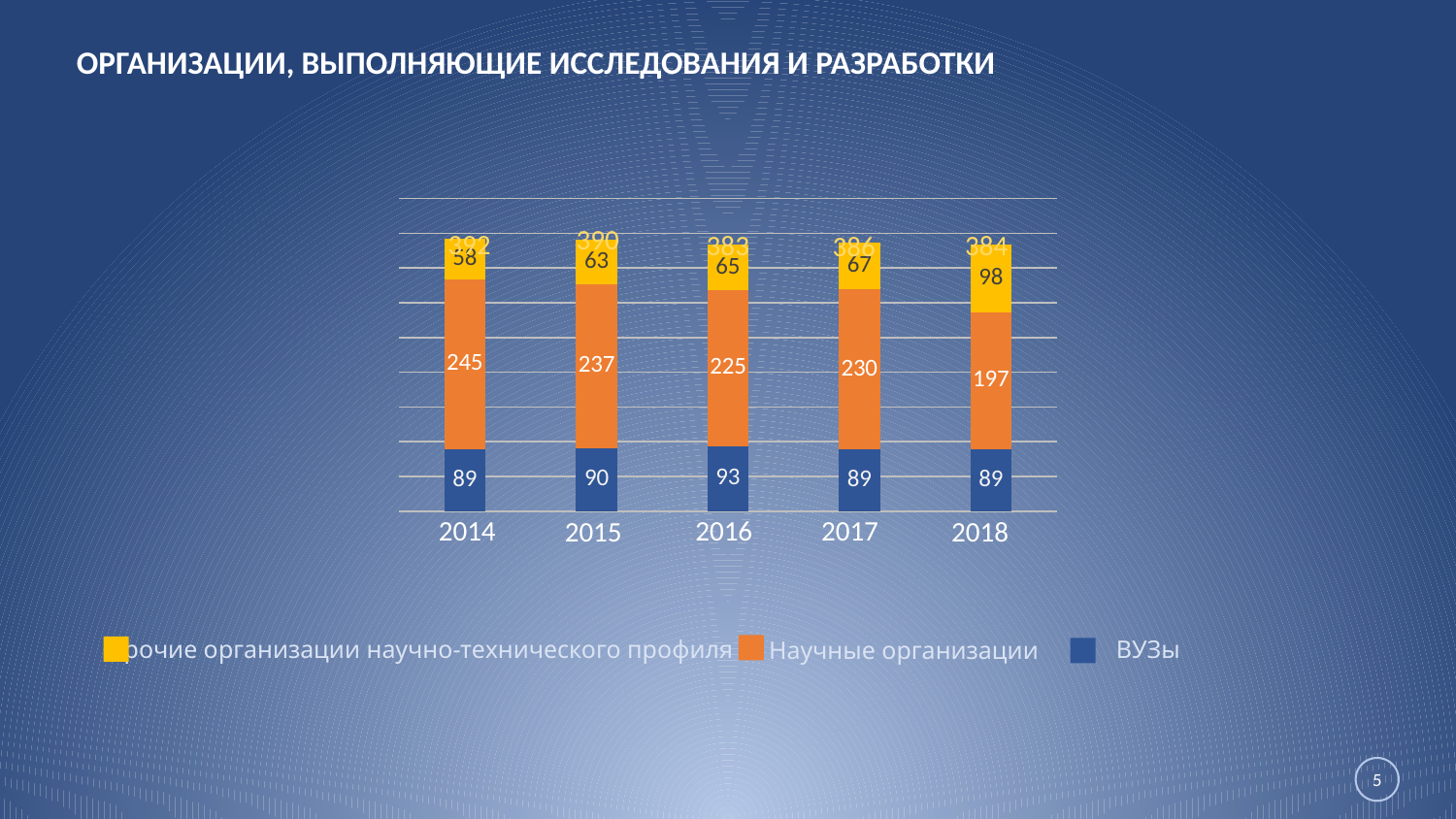
What is the difference between the Научные организации values for 2014 and 2018? 48 What is the value for ВУЗы in 2016? 93 Which is larger: the Научные организации value in 2016 or in 2017? 2017 What is the value for Научные организации in 2018? 197 In which year is the value for Научные организации the lowest? 2018 In which year is the value for ВУЗы the highest? 2016 What is the value for Научные организации in 2014? 245 What is the total of the stacked bar for 2016? 383 What type of chart is shown on the slide? Stacked bar chart How many series does the legend list? 3 How many years are shown on the x axis of the chart? 5 Does the value for Научные организации rise or fall from 2014 to 2016? Fall